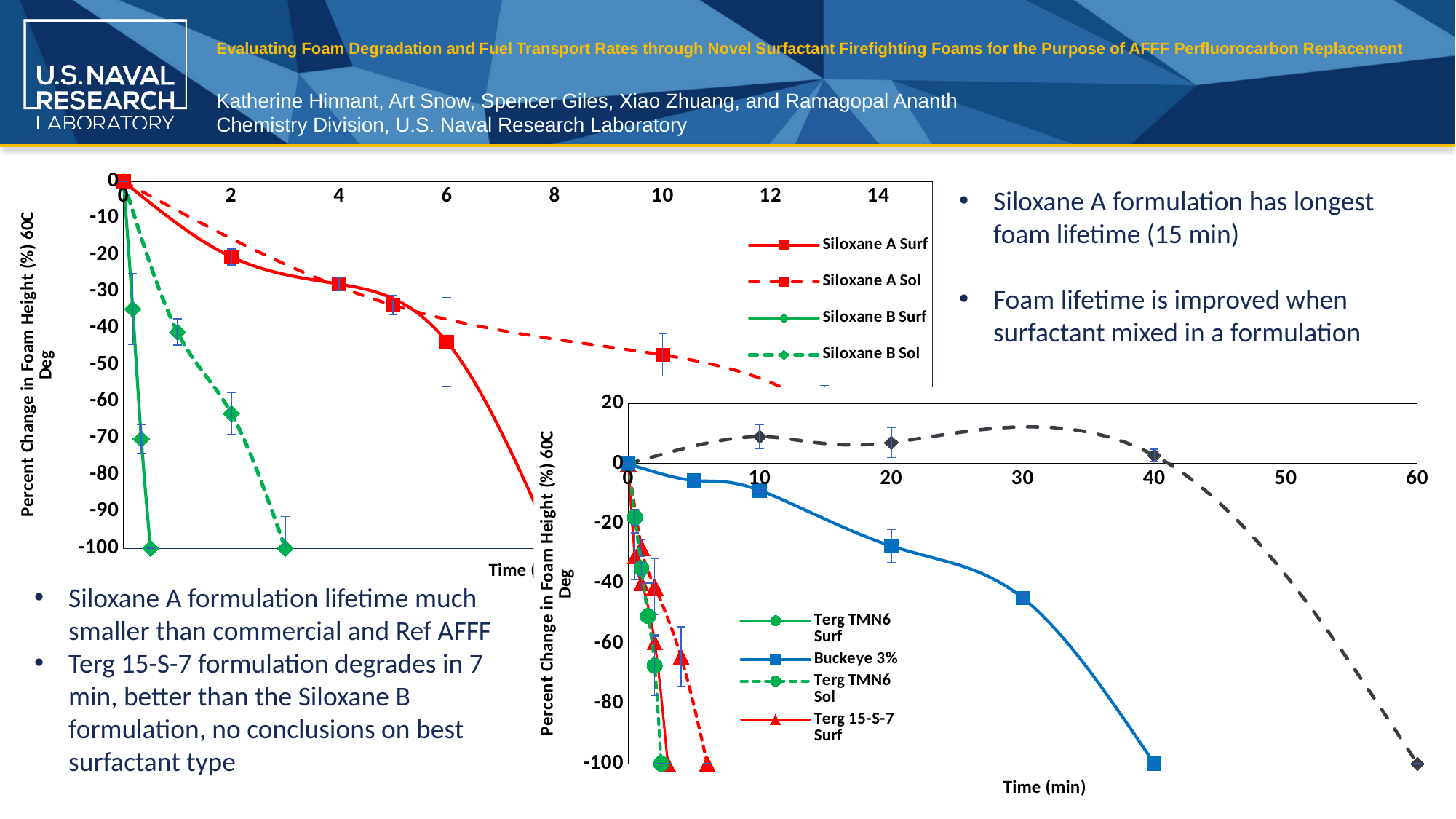
In the bottom-right chart, is the value for Buckeye 3% at 30 min greater or less than -60? greater In the top-left chart, at 2 min, which series has the higher value: Siloxane A Surf or Siloxane B Sol? Siloxane A Surf In the top-left chart, is the value for Siloxane A Surf at 2 min greater or less than -30? greater How many series does the legend of the bottom-right chart list? 4 In the bottom-right chart, is the value for Buckeye 3% at 30 min greater or less than -20? less What is the y-axis title of the bottom-right chart? Percent Change in Foam Height (%) 60C Deg How many series does the legend of the top-left chart list? 4 In the top-left chart, do the values for Siloxane A Sol rise or fall as time increases? fall What is the x-axis title of the bottom-right chart? Time (min) What kind of chart is the top-left chart on the slide? line chart